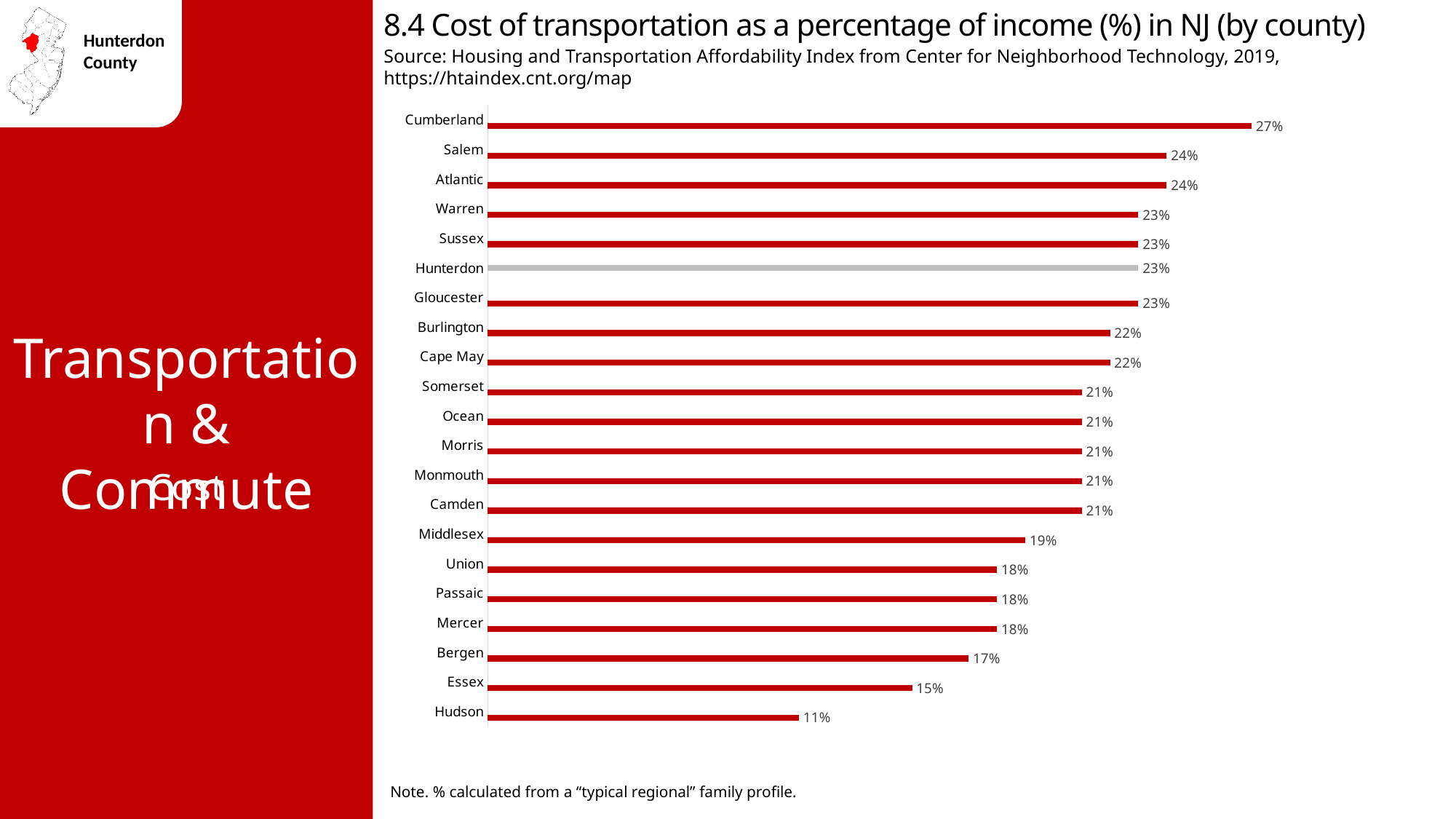
Which county has the highest cost of transportation as a percentage of income? Cumberland Which county's bar is coloured gray instead of red? Hunterdon How many counties are shown in the chart? 21 What is the difference in percentage points between Cumberland and Hudson? 16 What is the value shown for Bergen County? 17% What is the difference in percentage points between Salem and Essex? 9 Which has a higher value, Burlington or Union? Burlington What type of chart is shown on the slide? Bar chart What is the cost of transportation as a percentage of income for Hunterdon County? 23% What is the value shown for Hudson County? 11% Which county has the lowest cost of transportation as a percentage of income? Hudson What is the value shown for Middlesex County? 19%